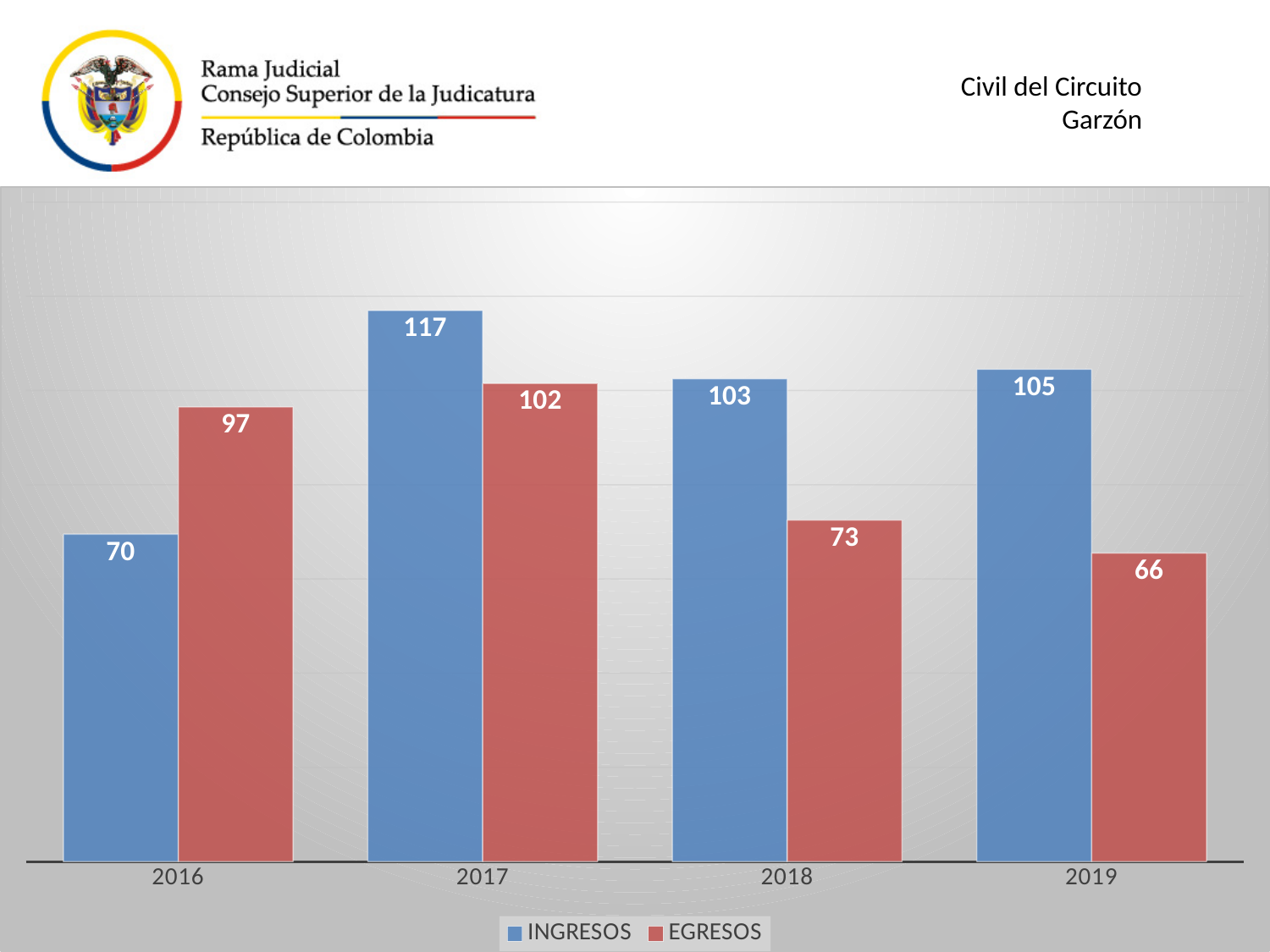
How many years are shown on the x axis? 4 How many series does the legend list? 2 What is the difference between the INGRESOS values for 2017 and 2016? 47 Which colour represents the EGRESOS series? Red Which year has the lowest EGRESOS value? 2019 Which year has the highest INGRESOS value? 2017 What kind of chart is shown on the slide? Bar chart What is the EGRESOS value for 2016? 97 What is the difference between INGRESOS and EGRESOS in 2018? 30 In 2016, which is larger, INGRESOS or EGRESOS? EGRESOS What is the INGRESOS value for 2017? 117 What is the EGRESOS value for 2019? 66